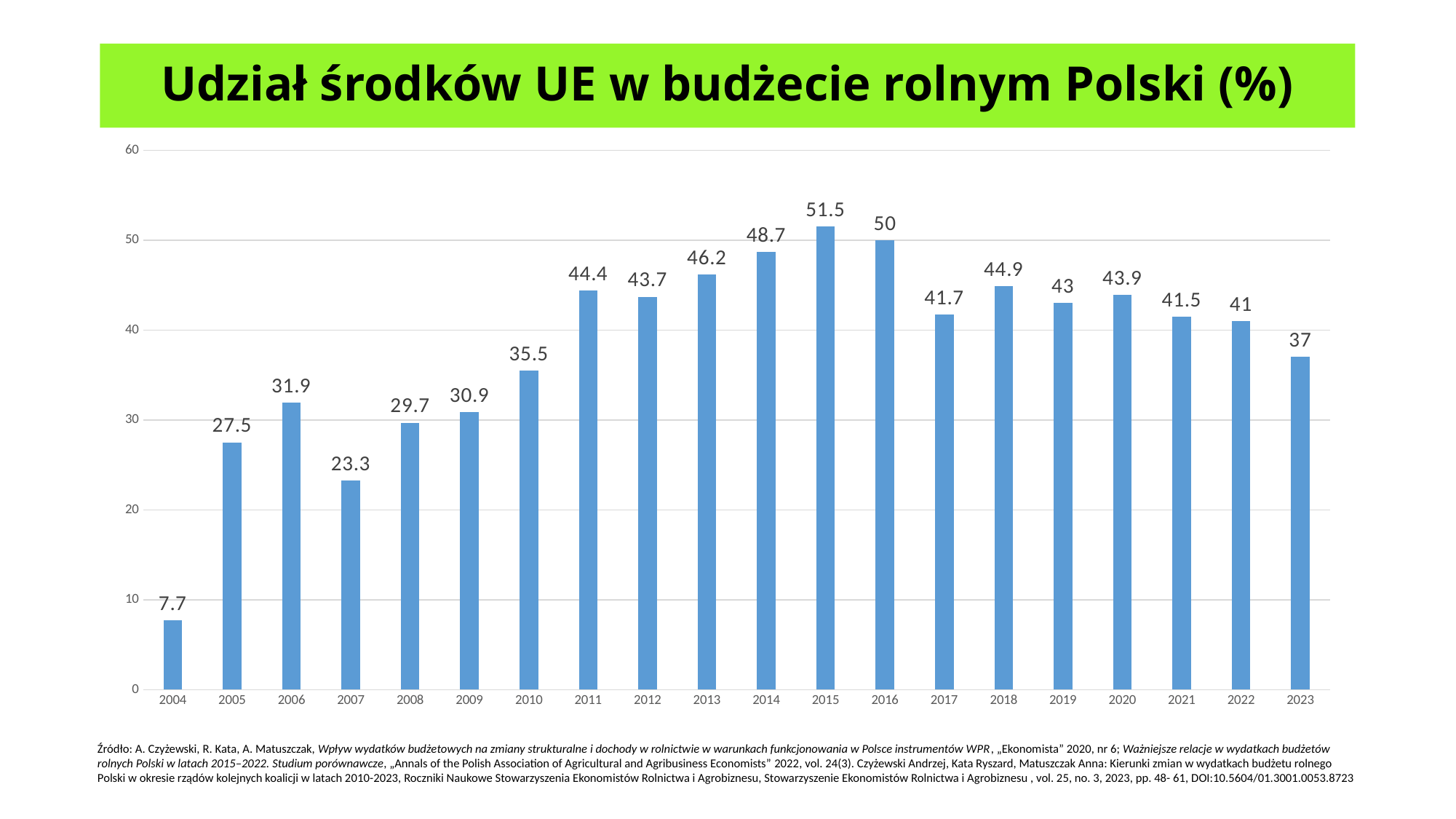
What is the value for 2015? 51.5 What kind of chart is shown on the slide? bar chart What is the value for 2004? 7.7 What is the title of the chart? Udział środków UE w budżecie rolnym Polski (%) Do the values rise or fall from 2004 to 2015? rise Is the value for 2010 greater or less than 40? less Which year has the lowest value? 2004 How many years are shown on the x axis? 20 What is the value for 2023? 37 Which year has the highest value? 2015 Which is larger, the value for 2013 or the value for 2018? 2013 What is the difference between the values for 2016 and 2017? 8.3